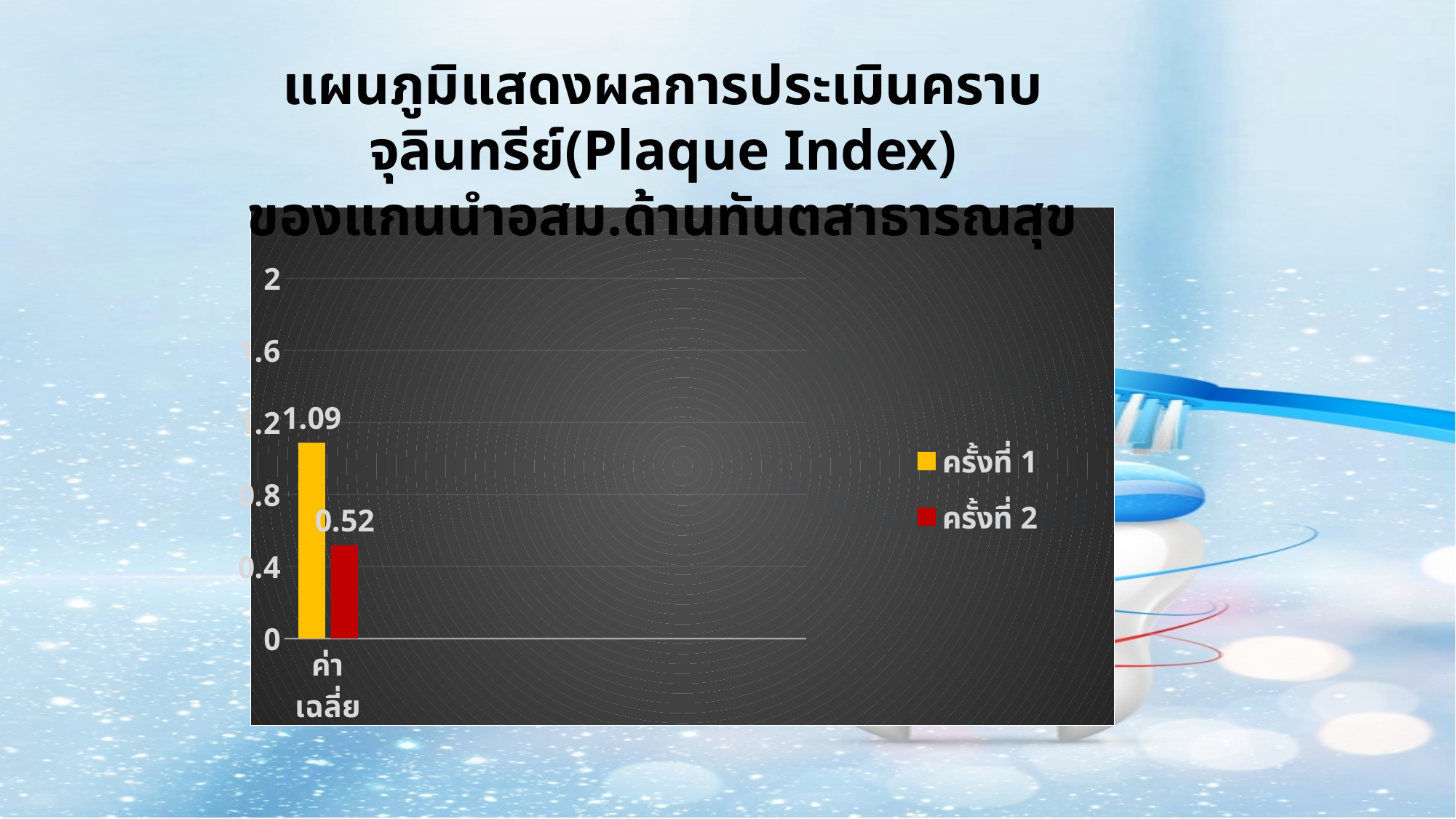
How many categories are shown on the x axis? 1 What is the value for ครั้งที่ 1 in the ค่าเฉลี่ย category? 1.09 Is the value for ครั้งที่ 1 greater or less than 0.8? greater Which series has the highest value on the chart? ครั้งที่ 1 Is the value for ครั้งที่ 2 greater or less than 0.8? less What kind of chart is shown on the slide? Bar chart What is the value for ครั้งที่ 2 in the ค่าเฉลี่ย category? 0.52 Which series has the higher value for ค่าเฉลี่ย, ครั้งที่ 1 or ครั้งที่ 2? ครั้งที่ 1 What is the difference between the ครั้งที่ 1 value and the ครั้งที่ 2 value? 0.57 Which series has the lowest value on the chart? ครั้งที่ 2 What colour is the bar for ครั้งที่ 2? Red How many series does the legend list? 2